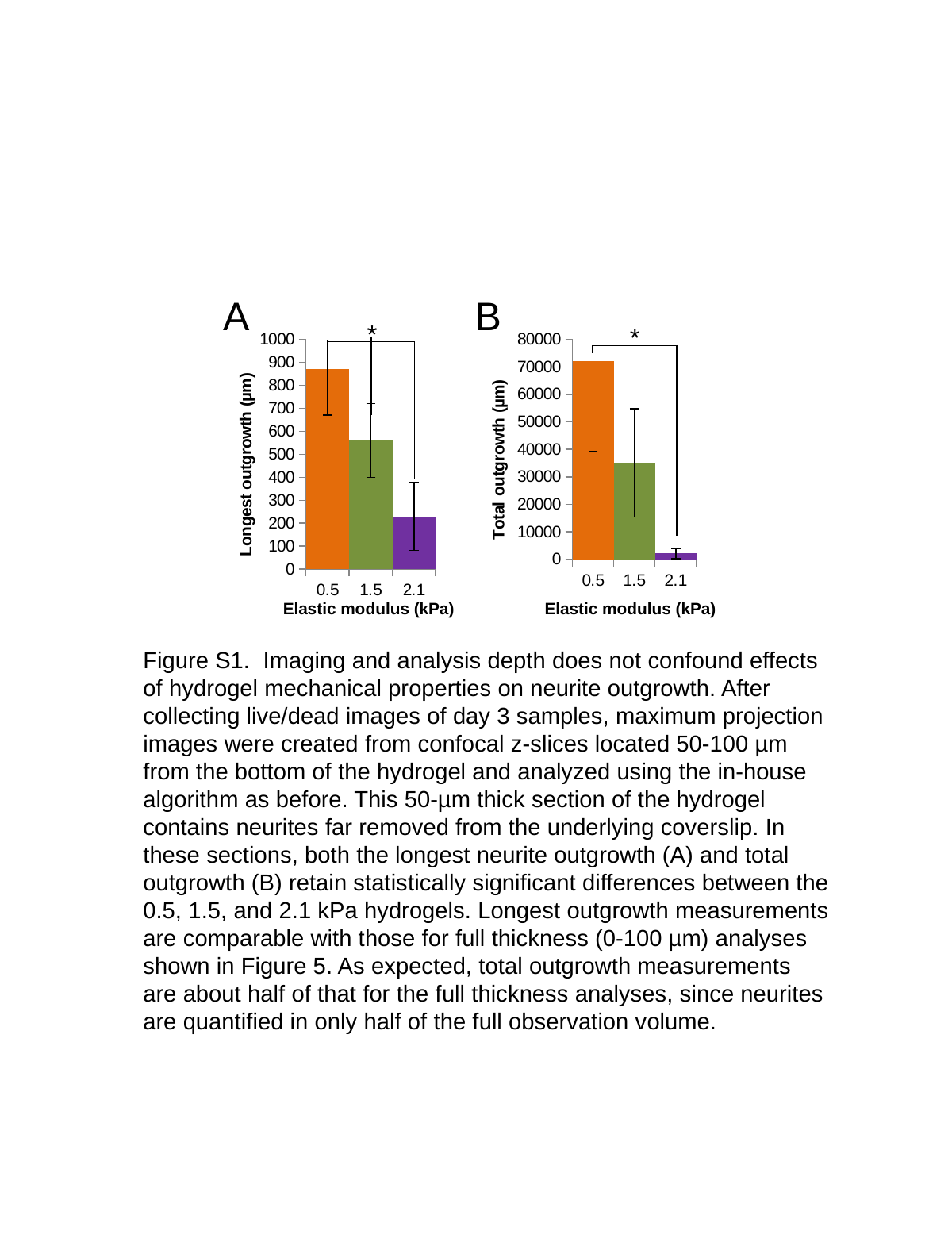
In chart A (Longest outgrowth), what kind of chart is shown? bar chart In chart B (Total outgrowth), is the value for 1.5 kPa greater or less than 30000? greater In chart A (Longest outgrowth), do the values rise or fall as elastic modulus increases along the x axis? fall In chart B (Total outgrowth), which elastic modulus has the lowest total outgrowth? 2.1 In chart B (Total outgrowth), which is larger, the value for 0.5 kPa or the value for 1.5 kPa? 0.5 kPa In chart A (Longest outgrowth), how many elastic modulus categories are plotted? 3 In chart B (Total outgrowth), what is the x-axis title? Elastic modulus (kPa) In chart A (Longest outgrowth), is the value for 2.1 kPa greater or less than 300? less In chart B (Total outgrowth), which elastic modulus has the highest total outgrowth? 0.5 In chart A (Longest outgrowth), is the value for 0.5 kPa greater or less than 800? greater In chart A (Longest outgrowth), which elastic modulus has the highest longest outgrowth? 0.5 In chart A (Longest outgrowth), which elastic modulus has the lowest longest outgrowth? 2.1